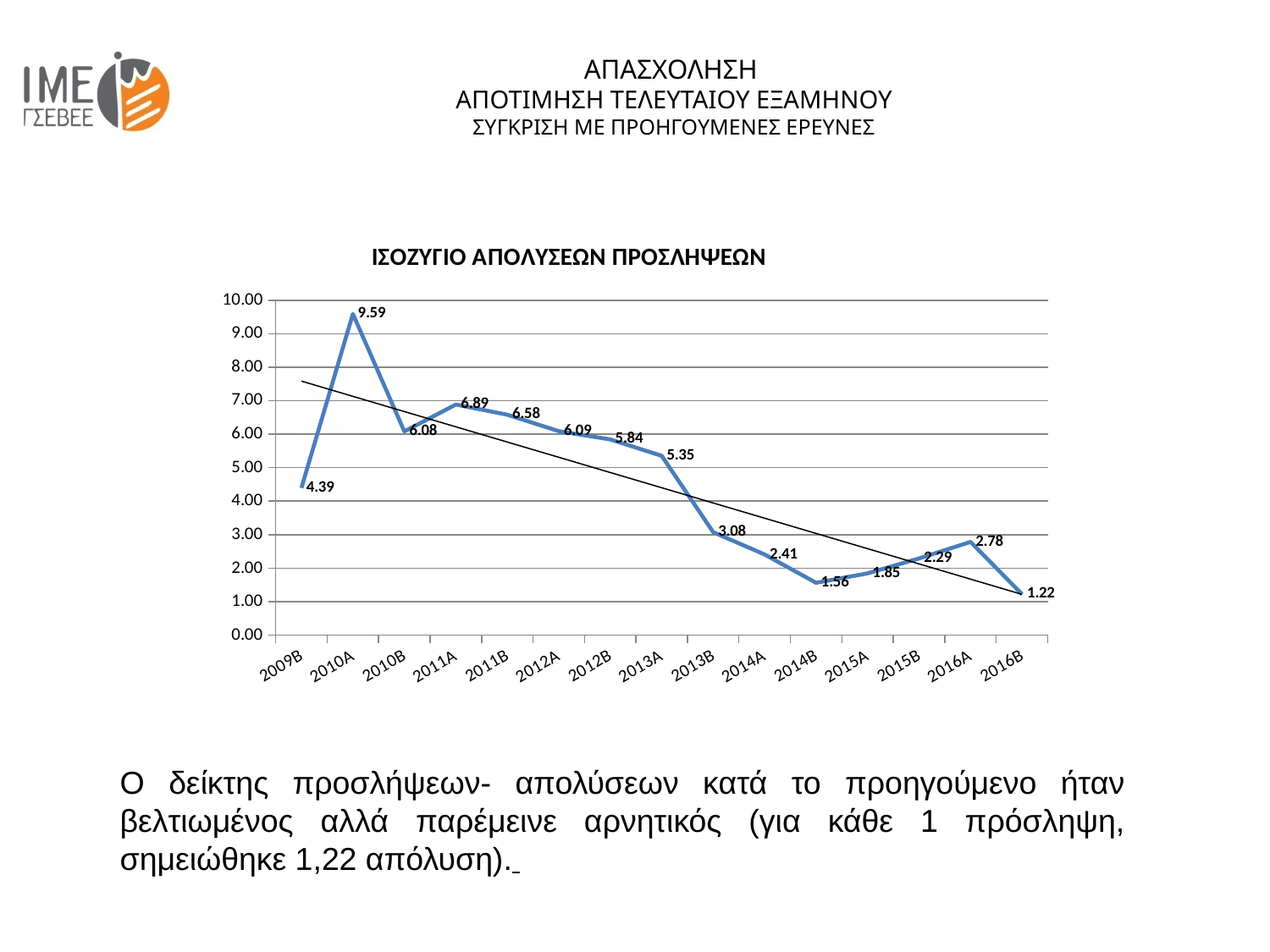
How many periods are plotted on the x axis? 15 What is the value for 2009B? 4.39 Which period has the lowest value? 2016B What is the value for 2016B? 1.22 Which is larger, the value for 2011A or the value for 2012A? 2011A What kind of chart is shown? Line chart What is the difference between the values for 2010A and 2010B? 3.51 What is the difference between the values for 2016A and 2016B? 1.56 Which period has the highest value? 2010A What is the value for 2010A? 9.59 What is the value for 2013B? 3.08 What is the title of the chart? ΙΣΟΖΥΓΙΟ ΑΠΟΛΥΣΕΩΝ ΠΡΟΣΛΗΨΕΩΝ